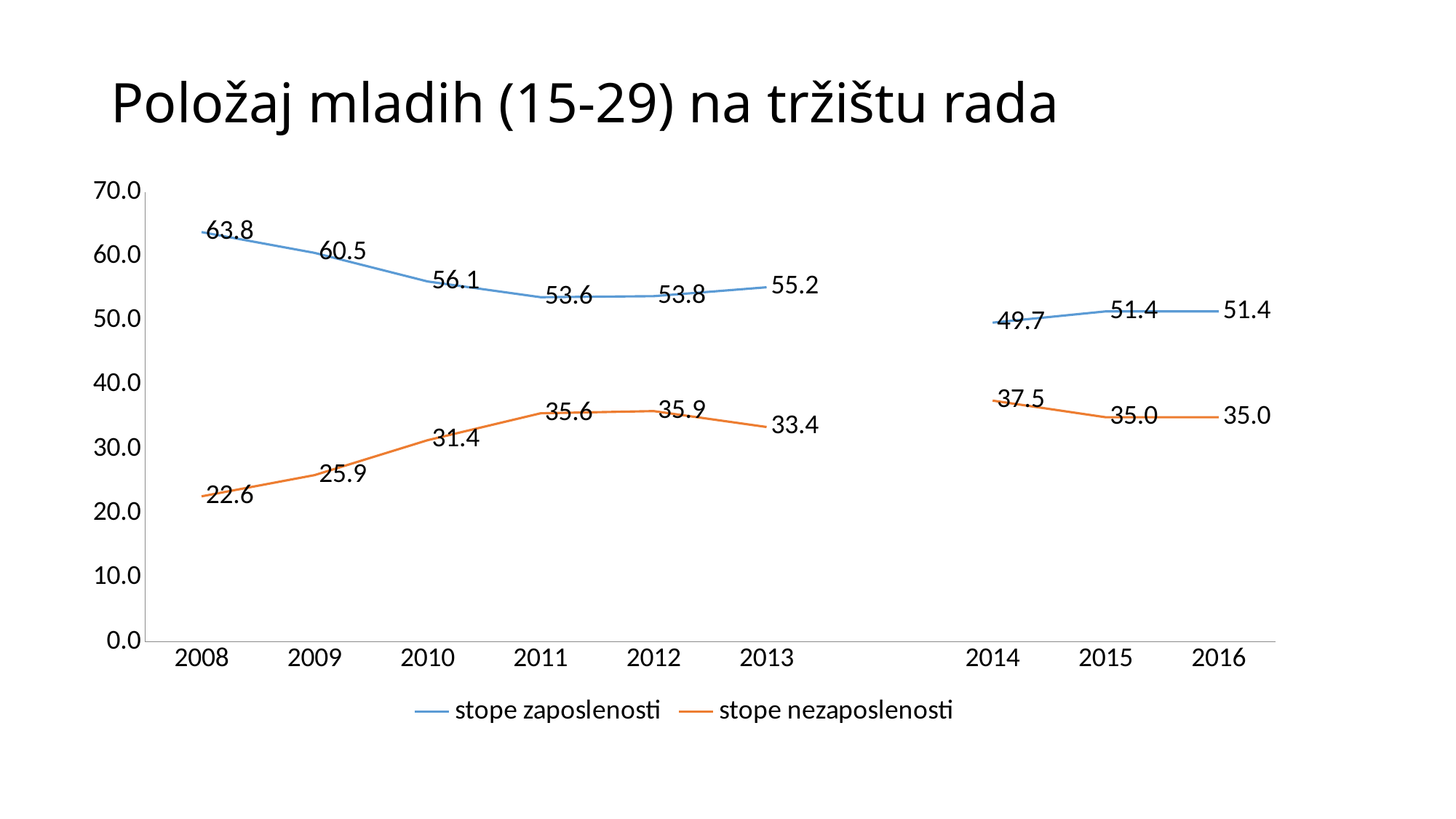
How many years are shown on the x axis? 9 What kind of chart is shown on the slide? line chart What is the value of stope nezaposlenosti in 2012? 35.9 What is the value of stope zaposlenosti in 2008? 63.8 What is the difference between stope zaposlenosti and stope nezaposlenosti in 2016? 16.4 Which is larger: stope nezaposlenosti in 2011 or in 2013? 2011 How many series does the legend list? 2 In which year is stope zaposlenosti highest? 2008 Does stope nezaposlenosti rise or fall from 2008 to 2011? rise What is the value of stope nezaposlenosti in 2014? 37.5 What is the difference between stope zaposlenosti in 2008 and in 2009? 3.3 In which year is stope nezaposlenosti lowest? 2008